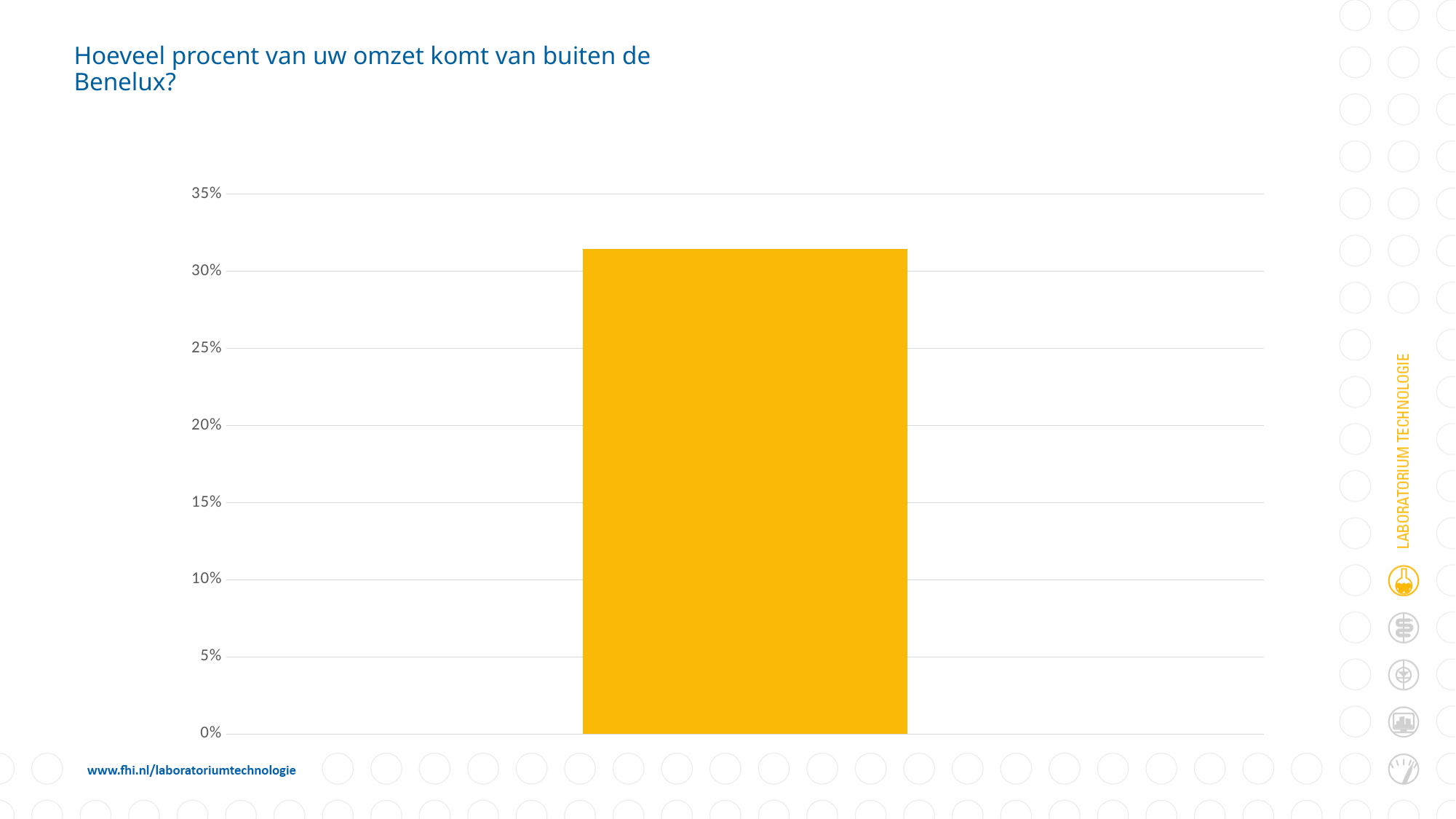
How many bars are plotted in the chart? 1 Is the value of the bar greater or less than 35%? less What is the title of the chart on the slide? Hoeveel procent van uw omzet komt van buiten de Benelux? Is the value of the bar greater or less than 25%? greater Is the value of the bar greater or less than 30%? greater What kind of chart is shown on the slide? bar chart What is the highest value shown on the vertical axis? 35%